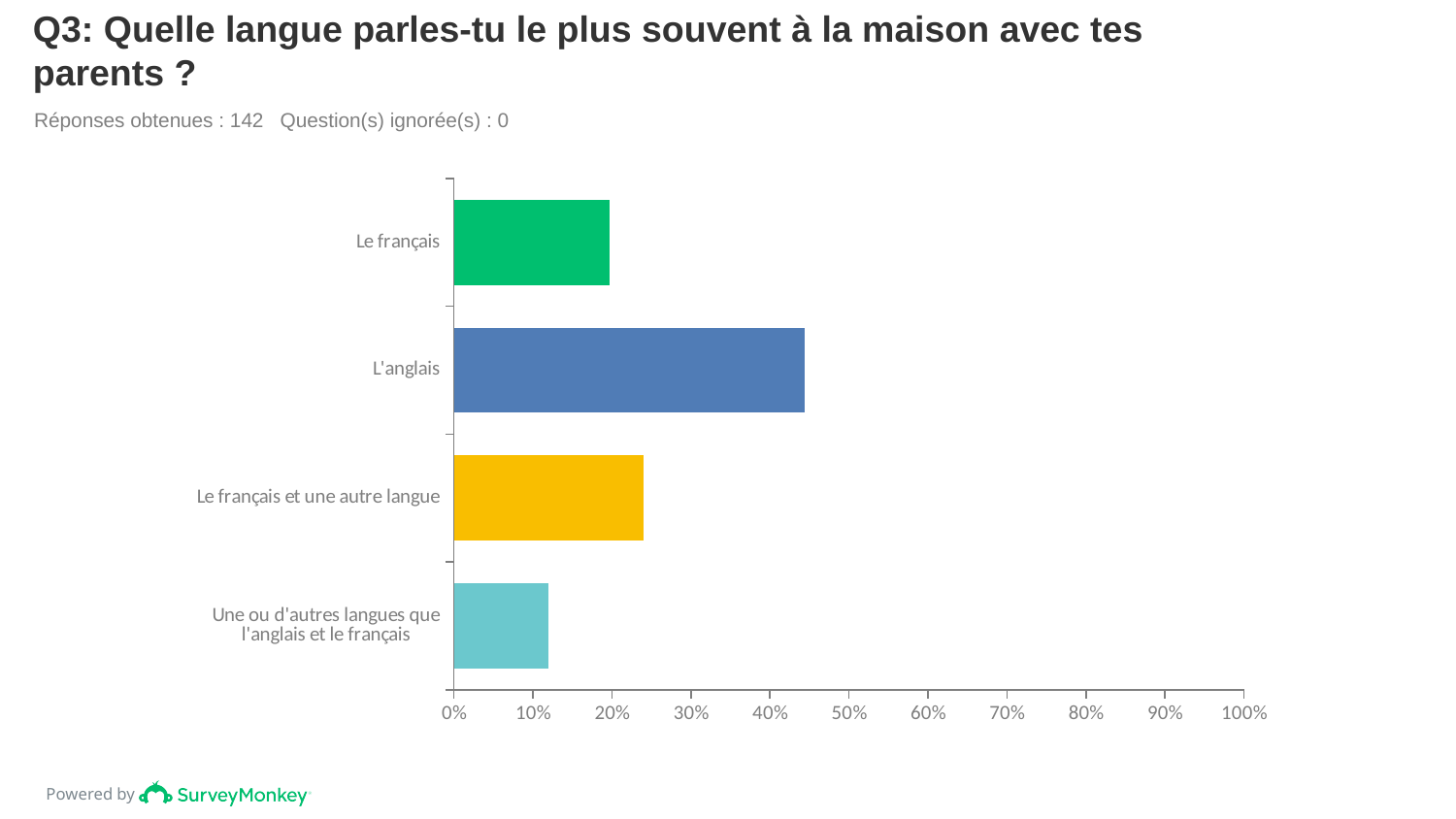
What is the maximum value shown on the horizontal axis? 100% Which is larger, the value for L'anglais or the value for Le français? L'anglais How many categories are shown in the chart? 4 What is the title of the chart? Q3: Quelle langue parles-tu le plus souvent à la maison avec tes parents ? Is the value for L'anglais greater or less than 40%? greater Is the value for Le français et une autre langue greater or less than 30%? less What kind of chart is shown on the slide? bar chart Which is larger, the value for Le français et une autre langue or the value for Une ou d'autres langues que l'anglais et le français? Le français et une autre langue Which category has the lowest value? Une ou d'autres langues que l'anglais et le français Is the value for Le français greater or less than 30%? less Which category has the highest value? L'anglais